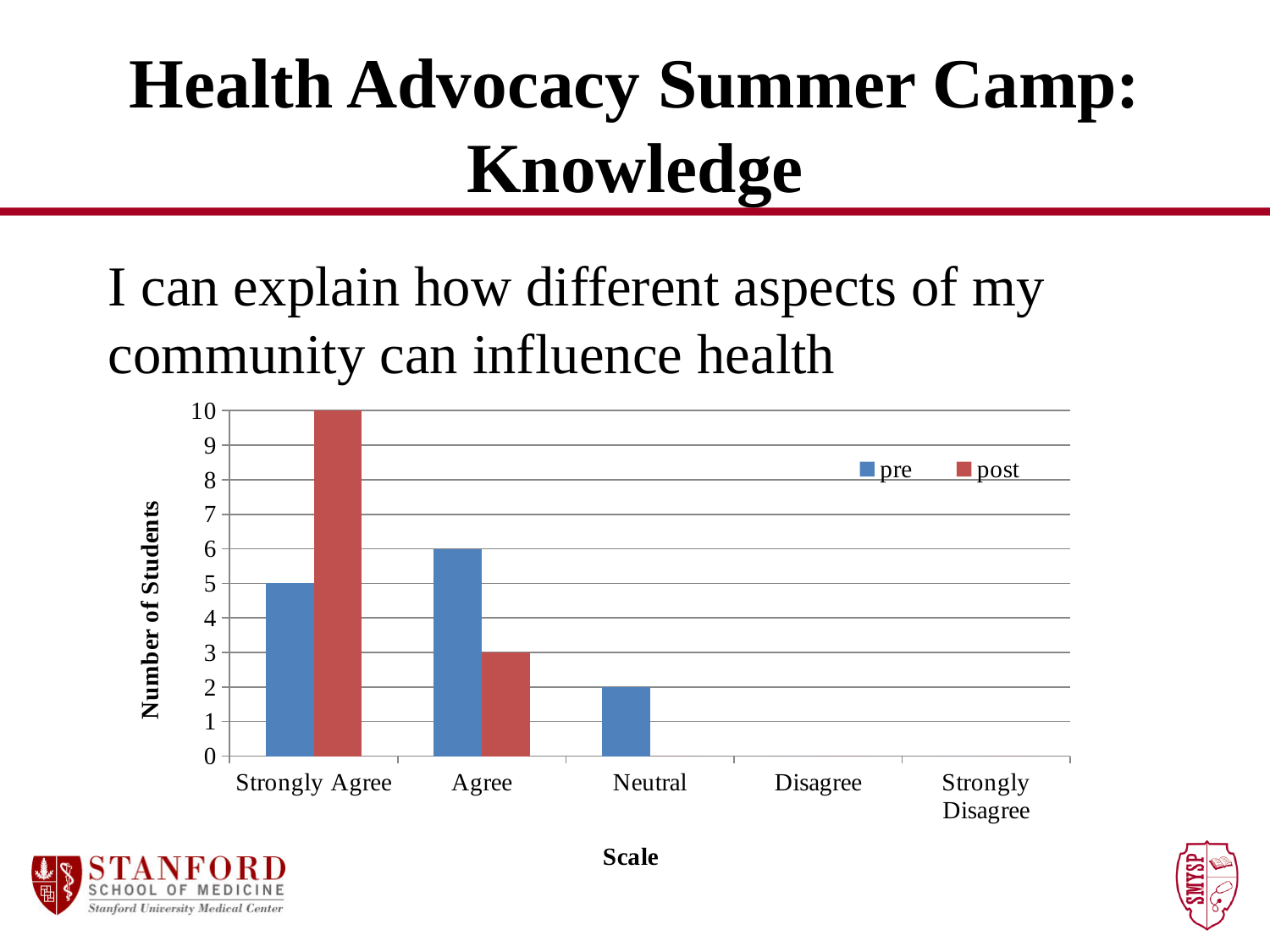
Which category has the highest post value? Strongly Agree What is the post value for Strongly Agree? 10 How many categories are shown on the x axis? 5 What is the pre value for Agree? 6 What type of chart is shown on the slide? bar chart Which is larger for Agree, the pre value or the post value? pre What is the pre value for Neutral? 2 What is the label of the y axis? Number of Students What is the post value for Agree? 3 What is the pre value for Strongly Agree? 5 How many series does the legend list? 2 What is the difference between the post and pre values for Strongly Agree? 5